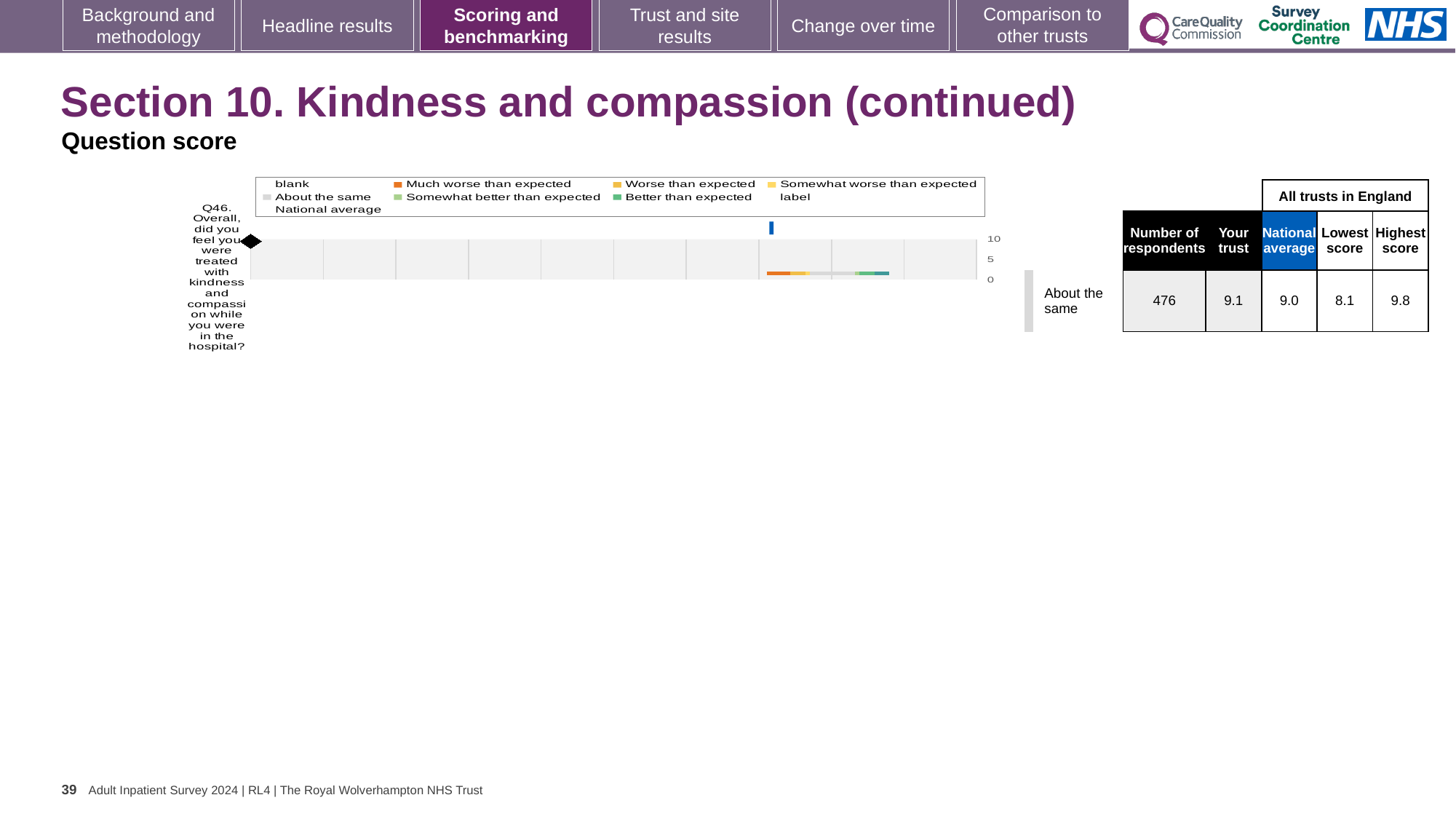
According to the table next to the chart, what is the Highest score among all trusts in England for Q46? 9.8 What kind of chart is shown on the slide? bar chart According to the table next to the chart, what is the Lowest score among all trusts in England for Q46? 8.1 What is the difference between the Highest score and the Lowest score for Q46 in the table? 1.7 How many questions (categories) are plotted on the chart? 1 According to the table next to the chart, how many respondents answered Q46? 476 Which is larger for Q46: the Your trust score or the National average score? Your trust According to the table next to the chart, what is the score for Your trust on Q46? 9.1 How many entries does the chart's legend list? 9 What is the highest tick value shown on the chart's axis? 10 According to the table next to the chart, what is the National average score for Q46? 9.0 Which question number is plotted on the chart? Q46